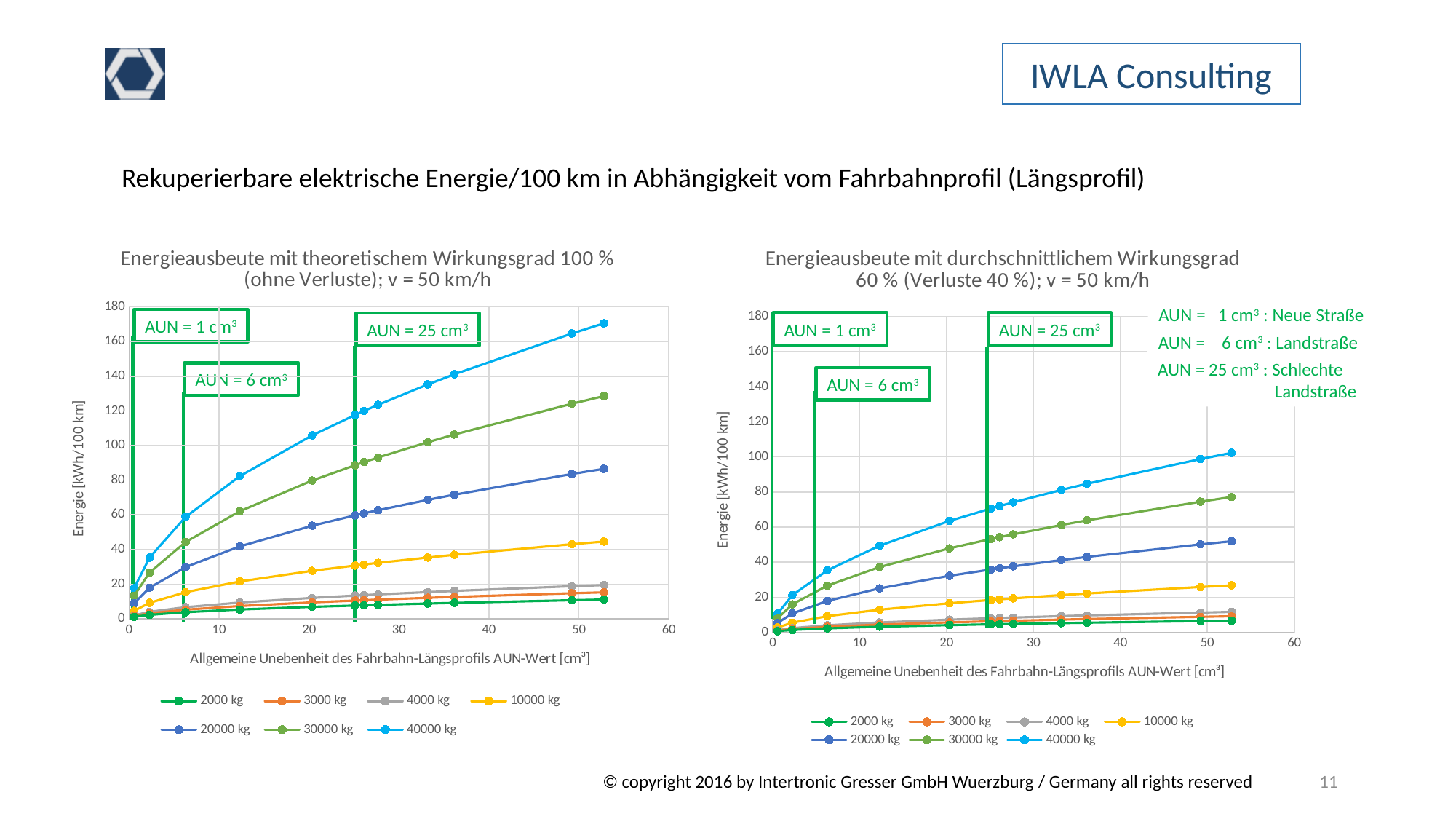
In the right chart (Wirkungsgrad 60 %), is the value for 20000 kg at the highest AUN value (around 53 cm³) greater or less than 40? greater According to the annotation next to the right chart, what road type corresponds to AUN = 25 cm³? Schlechte Landstraße How many series does the legend of the right chart (Energieausbeute mit durchschnittlichem Wirkungsgrad 60 %) list? 7 In the right chart (Wirkungsgrad 60 %), which series has the lowest energy values across the AUN range? 2000 kg In the left chart (Wirkungsgrad 100 %), is the value for 30000 kg at the highest AUN value (around 53 cm³) greater or less than 120? greater What type of chart is the left chart (Energieausbeute mit theoretischem Wirkungsgrad 100 %)? Line chart In the left chart (Wirkungsgrad 100 %), which series has the highest energy values across the AUN range? 40000 kg In the left chart (Wirkungsgrad 100 %), is the value for 40000 kg at the highest AUN value (around 53 cm³) greater or less than 160? greater What is the y-axis label of the left chart (Wirkungsgrad 100 %)? Energie [kWh/100 km] In the left chart (Wirkungsgrad 100 %), do the energy values rise or fall as the AUN value increases? Rise In the right chart (Wirkungsgrad 60 %), at AUN = 25 cm³, which series is larger: 40000 kg or 30000 kg? 40000 kg